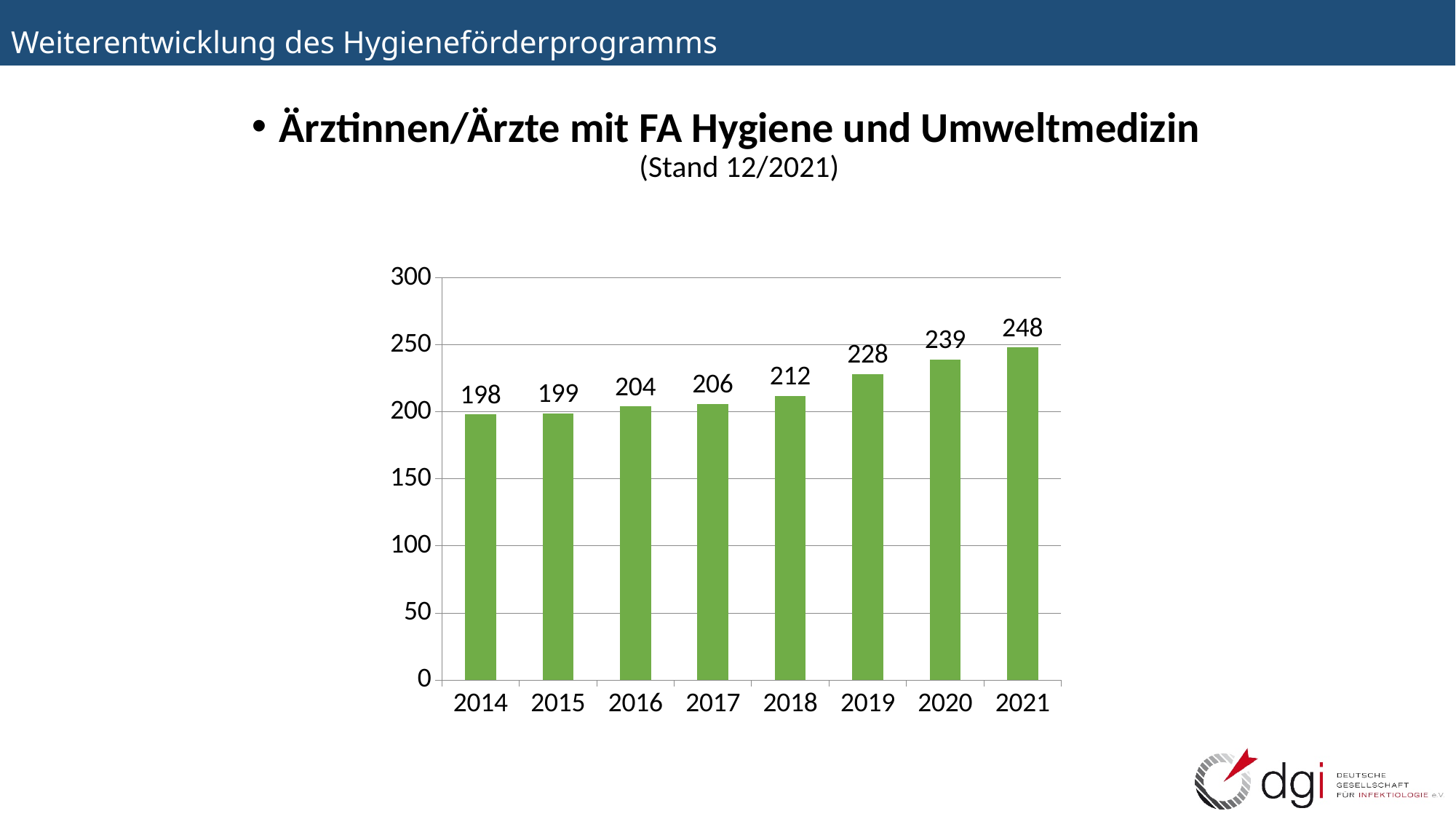
What is the value for 2019? 228 What is the difference between the values for 2021 and 2014? 50 How many years are shown on the x axis? 8 Which year has the highest value? 2021 Which year has the lowest value? 2014 What is the value for 2021? 248 What is the difference between the values for 2020 and 2019? 11 What is the value for 2014? 198 Is the value for 2017 greater or less than 250? less What kind of chart is shown on the slide? bar chart Which is larger, the value for 2018 or the value for 2020? 2020 Do the values rise or fall from 2014 to 2021? rise